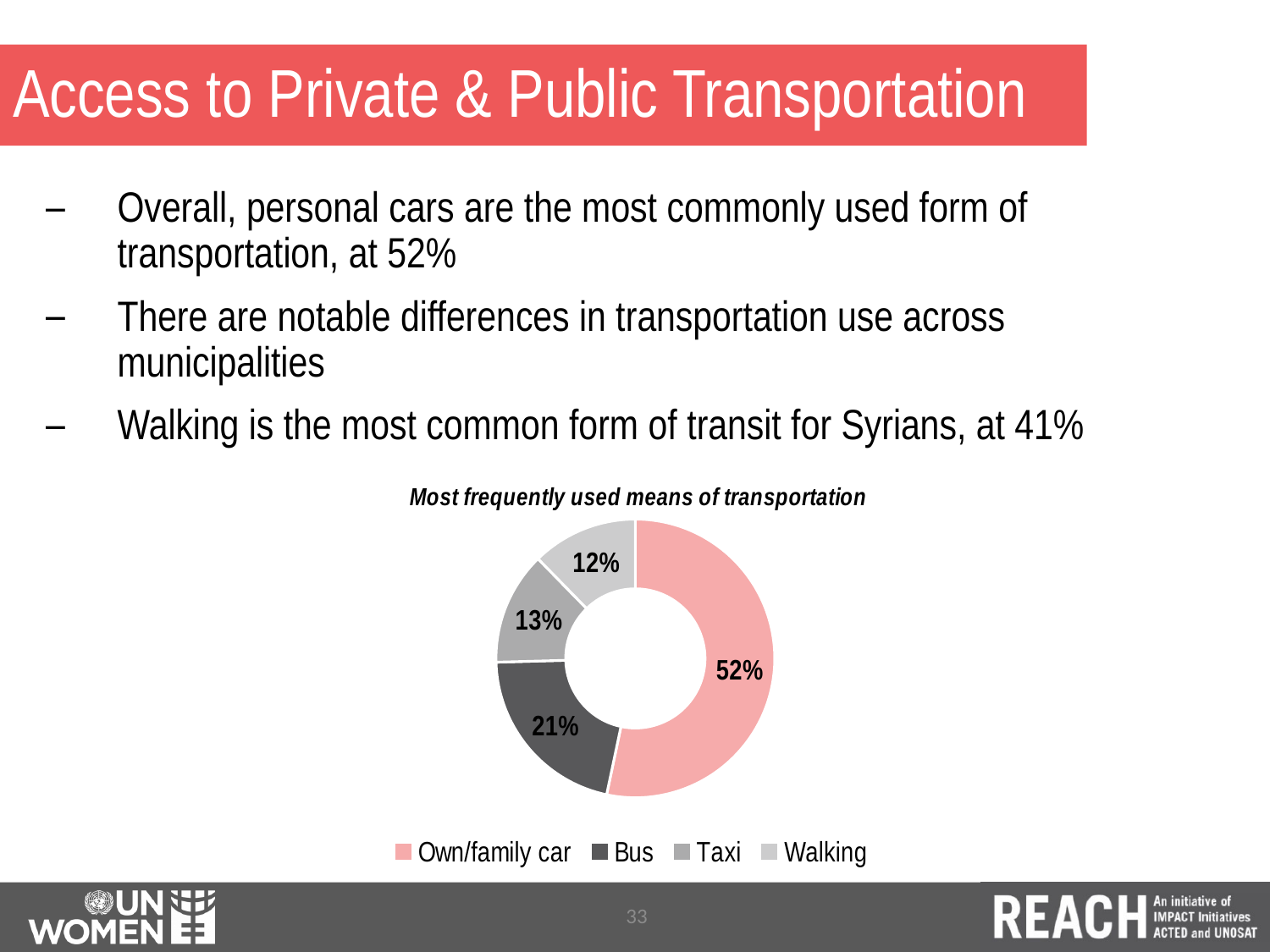
What is the title of the chart? Most frequently used means of transportation What is the difference in percentage points between Own/family car and Bus? 31 What percentage of the chart is Own/family car? 52% Which has a larger share, Bus or Taxi? Bus What percentage of the chart is Taxi? 13% How many categories are shown in the chart? 4 What type of chart is shown on the slide? Doughnut chart Which means of transportation has the largest share in the chart? Own/family car What percentage of the chart is Walking? 12% What percentage of the chart is Bus? 21% How many entries does the legend list? 4 Which means of transportation has the smallest share in the chart? Walking